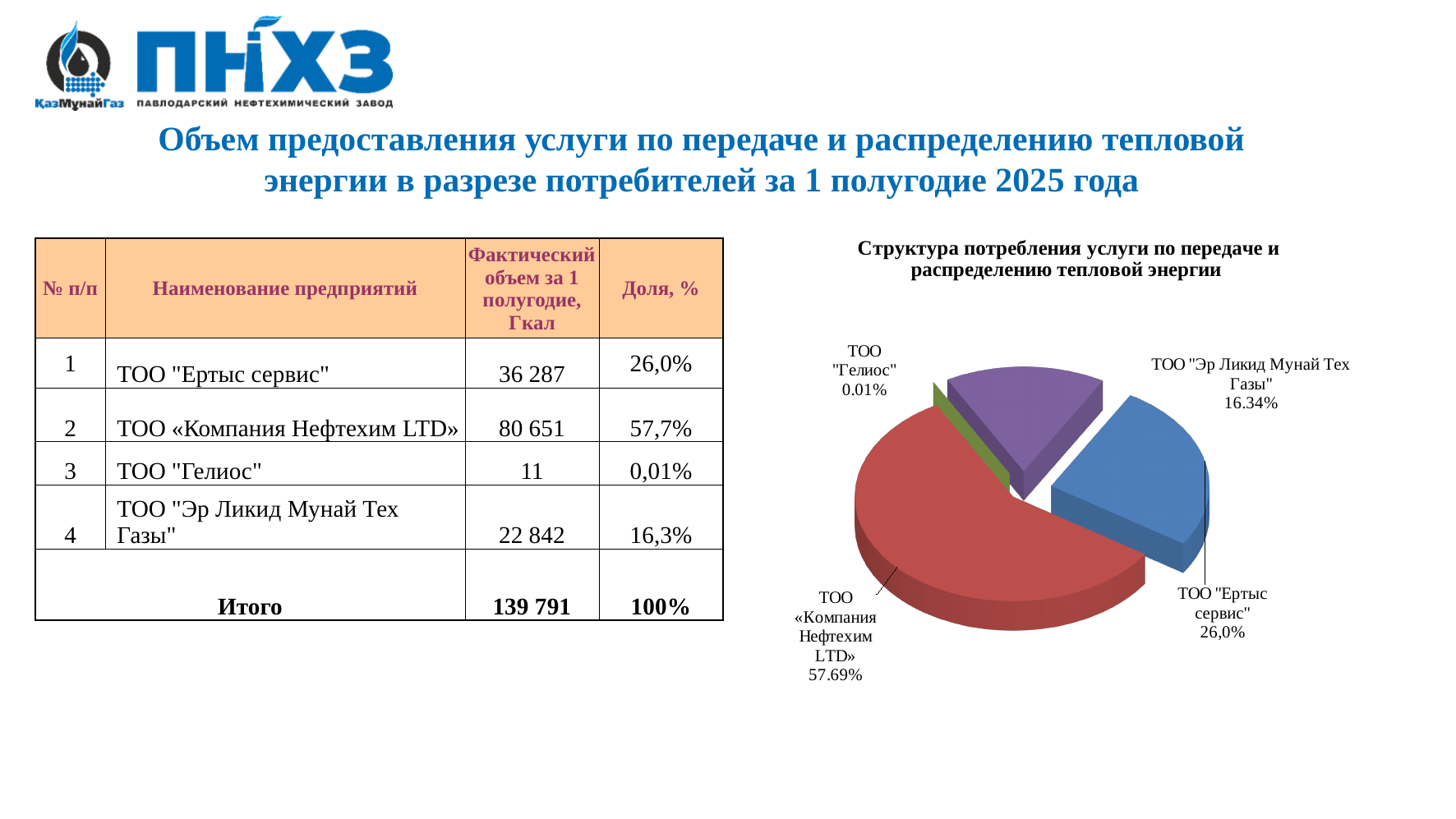
In the pie chart, which slice is larger: ТОО "Ертыс сервис" or ТОО "Эр Ликид Мунай Тех Газы"? ТОО "Ертыс сервис" What share of the pie chart does ТОО "Ертыс сервис" have? 26,0% What is the title of the pie chart? Структура потребления услуги по передаче и распределению тепловой энергии How many slices does the pie chart have? 4 In the pie chart, what is the difference in share between ТОО «Компания Нефтехим LTD» and ТОО "Эр Ликид Мунай Тех Газы"? 41.35% What share of the pie chart does ТОО «Компания Нефтехим LTD» have? 57.69% What colour is the slice for ТОО «Компания Нефтехим LTD» in the pie chart? red What share of the pie chart does ТОО "Эр Ликид Мунай Тех Газы" have? 16.34% Which company has the smallest slice in the pie chart? ТОО "Гелиос" Which company has the largest slice in the pie chart? ТОО «Компания Нефтехим LTD» What kind of chart is shown on the slide? pie chart